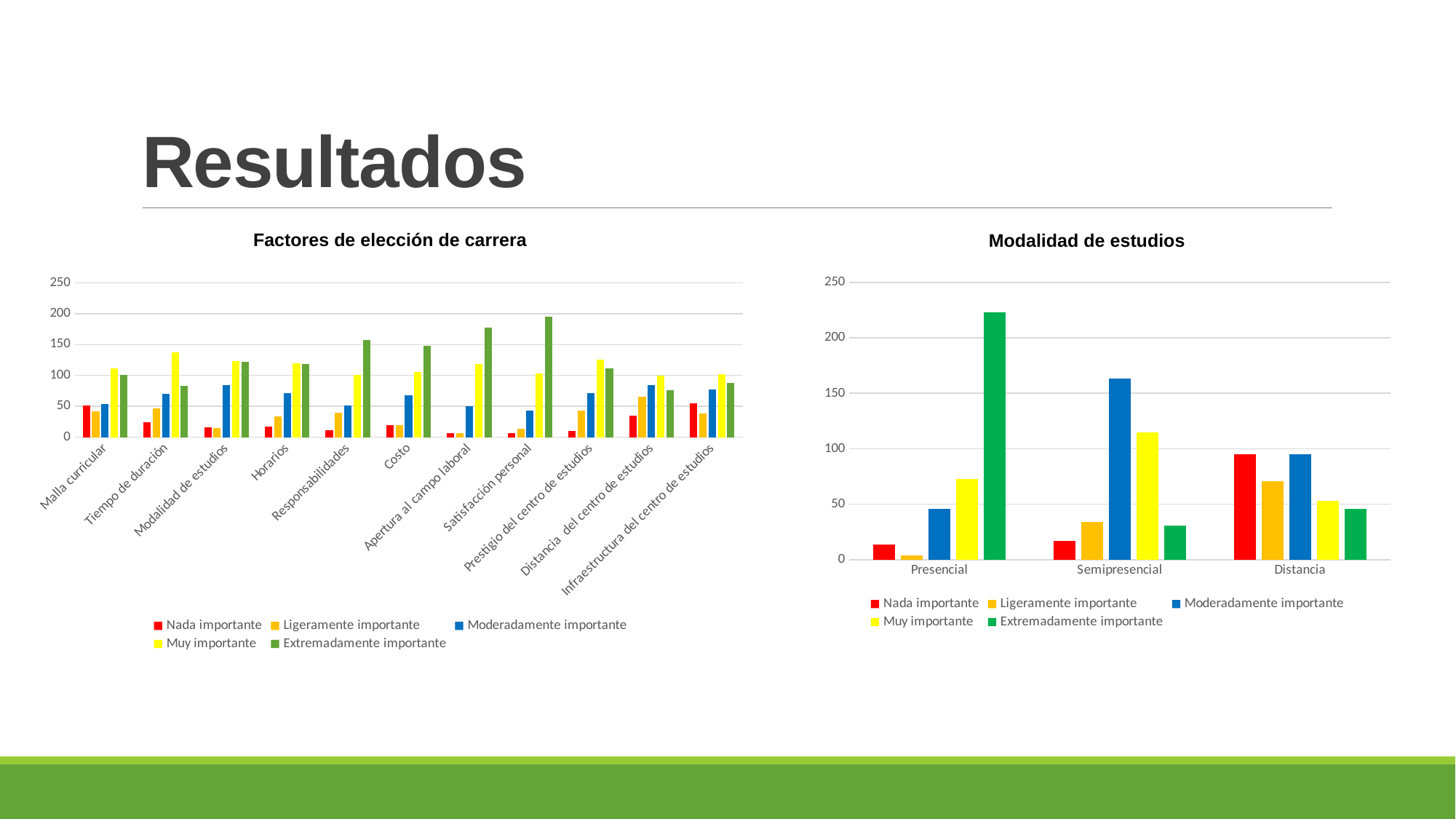
In the 'Factores de elección de carrera' chart, for Tiempo de duración, which is larger: 'Muy importante' or 'Extremadamente importante'? Muy importante In the 'Modalidad de estudios' chart, which modality has the lowest 'Ligeramente importante' bar? Presencial In the 'Factores de elección de carrera' chart, is the 'Extremadamente importante' value for Satisfacción personal greater or less than 150? greater In the 'Modalidad de estudios' chart, for Distancia, which is larger: 'Nada importante' or 'Extremadamente importante'? Nada importante In the 'Modalidad de estudios' chart, which modality has the highest 'Extremadamente importante' bar? Presencial How many categories are shown on the x axis of the 'Modalidad de estudios' chart? 3 In the 'Modalidad de estudios' chart, is the 'Extremadamente importante' value for Presencial greater or less than 200? greater In the 'Factores de elección de carrera' chart, is the 'Muy importante' value for Tiempo de duración greater or less than 100? greater What kind of chart is the 'Factores de elección de carrera' chart? bar chart How many series does the legend of the 'Factores de elección de carrera' chart list? 5 How many categories are shown on the x axis of the 'Factores de elección de carrera' chart? 11 In the 'Factores de elección de carrera' chart, which category has the highest 'Extremadamente importante' bar? Satisfacción personal